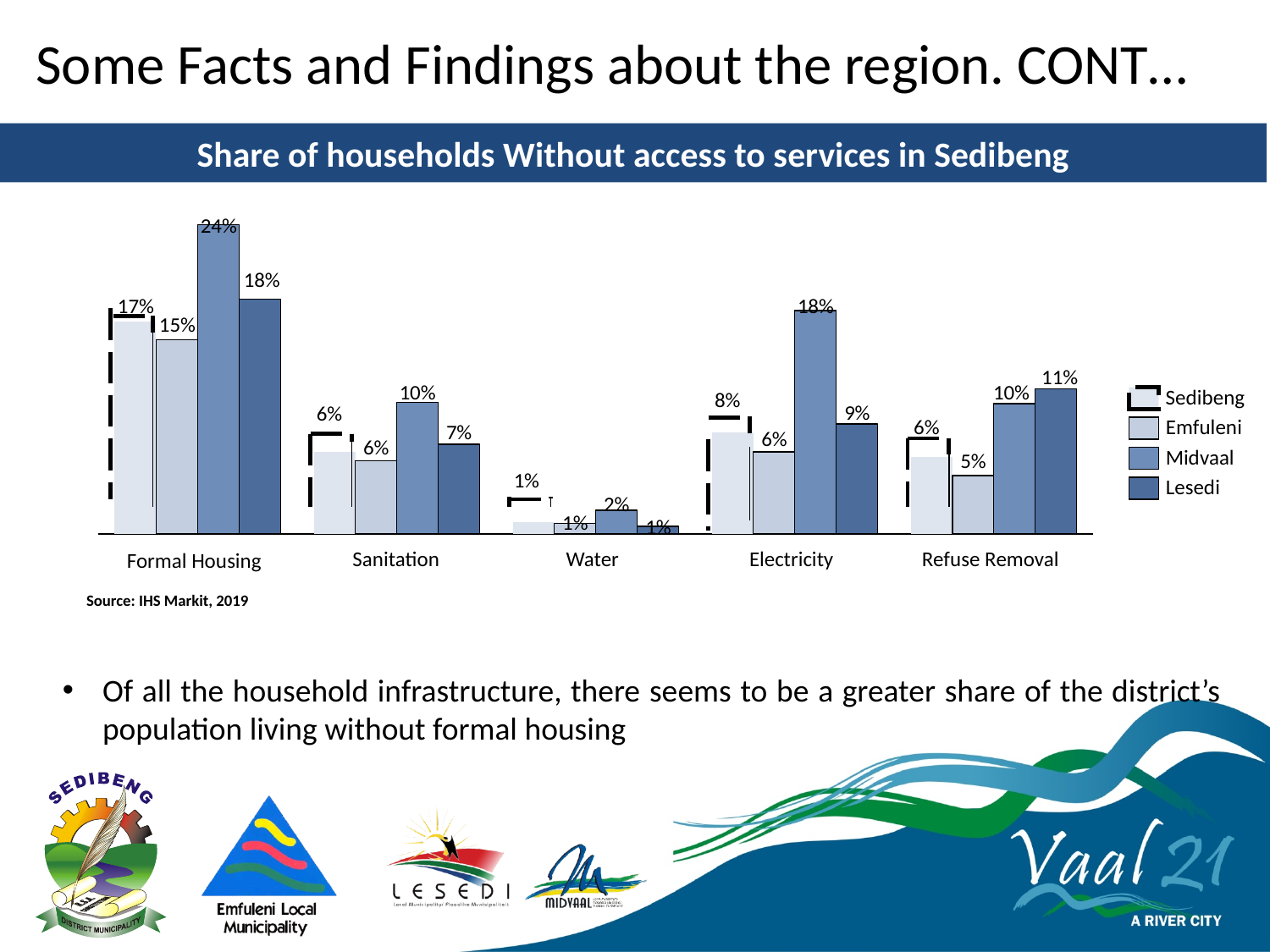
How many series does the legend list? 4 Which is larger in the Refuse Removal category: Midvaal or Lesedi? Lesedi What is the value for Lesedi in the Refuse Removal category? 11% What is the value for Sedibeng in the Electricity category? 8% What kind of chart is shown on the slide? Bar chart What is the difference between Midvaal and Emfuleni in the Formal Housing category? 9% What is the difference between Midvaal and Sedibeng in the Electricity category? 10% What is the value for Emfuleni in the Sanitation category? 6% What is the value for Midvaal in the Formal Housing category? 24% How many service categories are shown on the x axis? 5 Which municipality has the highest value in the Electricity category? Midvaal Which category has the lowest values across all municipalities? Water